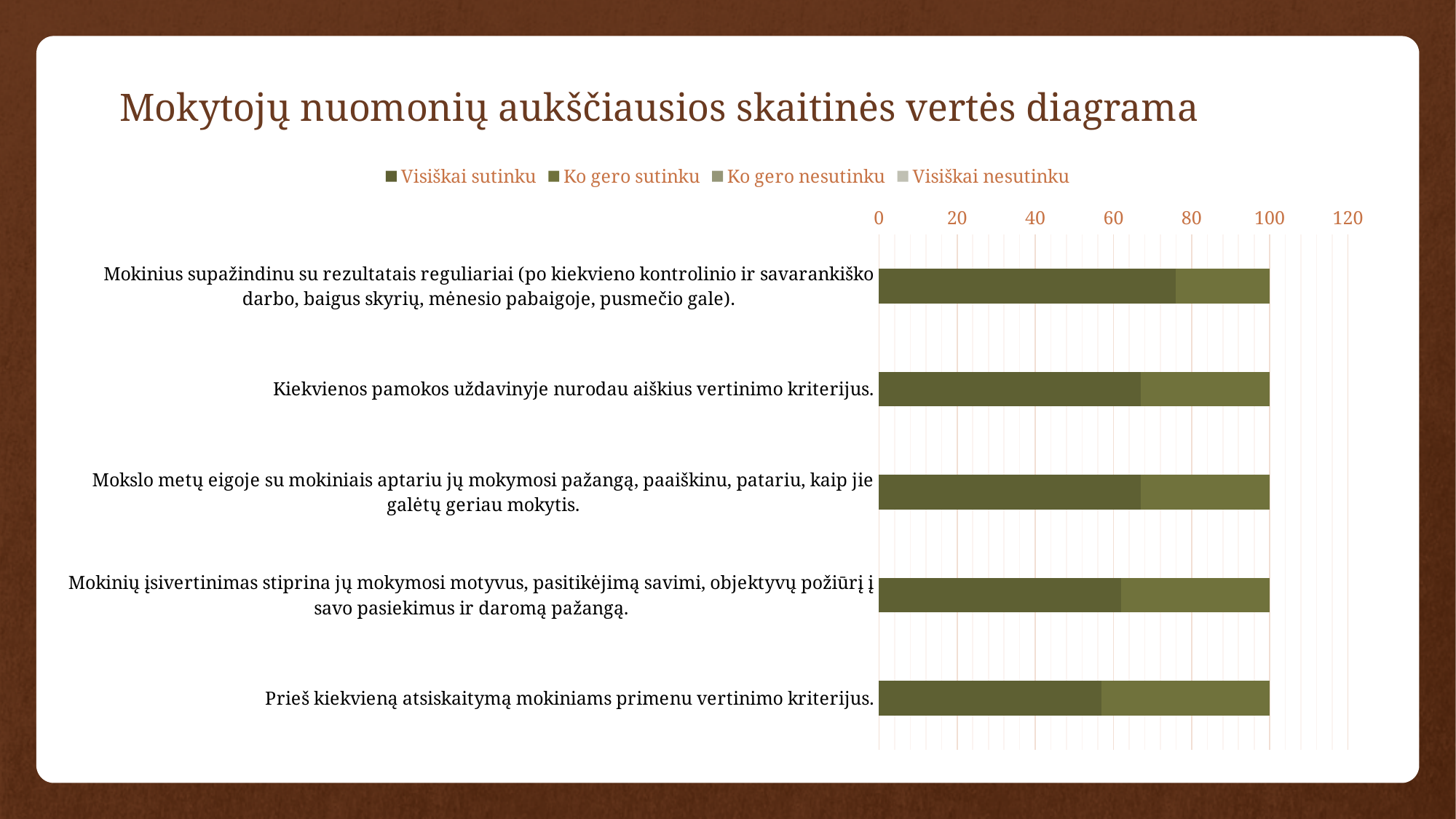
What is the first entry in the chart's legend? Visiškai sutinku How many series does the legend list? 4 Which has the larger "Visiškai sutinku" segment: "Mokinius supažindinu su rezultatais reguliariai..." or "Prieš kiekvieną atsiskaitymą mokiniams primenu vertinimo kriterijus."? Mokinius supažindinu su rezultatais reguliariai... What is the highest value shown on the horizontal axis? 120 Is the "Visiškai sutinku" value for "Mokinių įsivertinimas stiprina jų mokymosi motyvus..." greater or less than 40? greater How many categories (statements) are plotted on the chart? 5 What is the total of the stacked bar for "Kiekvienos pamokos uždavinyje nurodau aiškius vertinimo kriterijus."? 100 What kind of chart is shown on the slide? Bar chart Which statement has the largest "Visiškai sutinku" segment? Mokinius supažindinu su rezultatais reguliariai (po kiekvieno kontrolinio ir savarankiško darbo, baigus skyrių, mėnesio pabaigoje, pusmečio gale). What is the title of the chart? Mokytojų nuomonių aukščiausios skaitinės vertės diagrama Is the "Visiškai sutinku" value for "Prieš kiekvieną atsiskaitymą mokiniams primenu vertinimo kriterijus." greater or less than 80? less Is the "Visiškai sutinku" value for "Mokinius supažindinu su rezultatais reguliariai..." greater or less than 60? greater